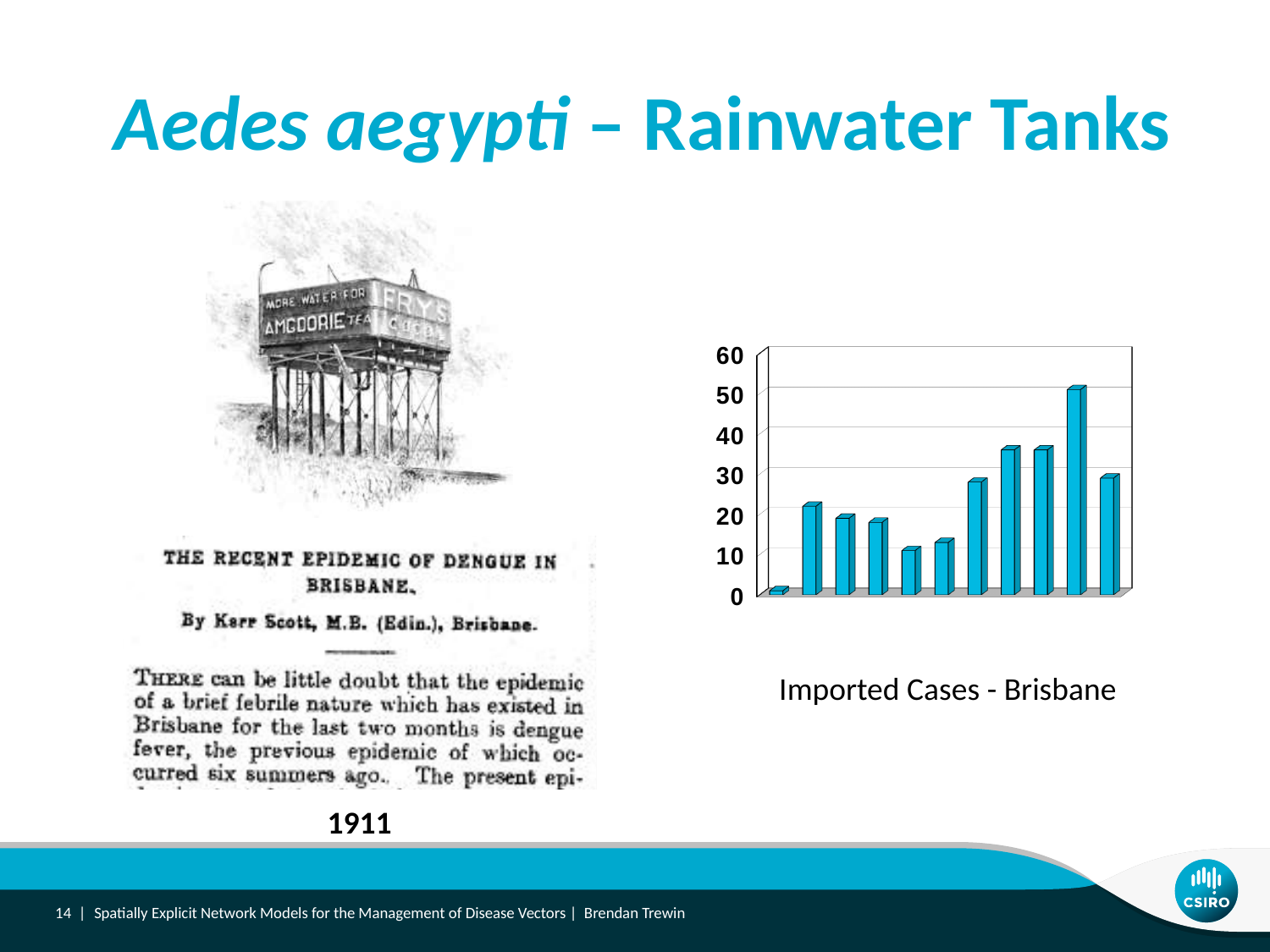
How many bars are plotted in the chart? 11 Which bar is the shortest in the chart? the first bar (leftmost) Is the value of the leftmost bar greater or less than 10? less Is the value of the seventh bar from the left greater or less than 20? greater Is the value of the tallest bar greater or less than 40? greater Which is larger, the tenth bar or the eighth bar from the left? the tenth bar Which is larger, the second bar from the left or the first bar? the second bar What kind of chart is shown on the slide? bar chart What is the highest value shown on the vertical axis? 60 Which bar is the tallest in the chart? the tenth bar (second from the right) What caption appears below the chart? Imported Cases - Brisbane